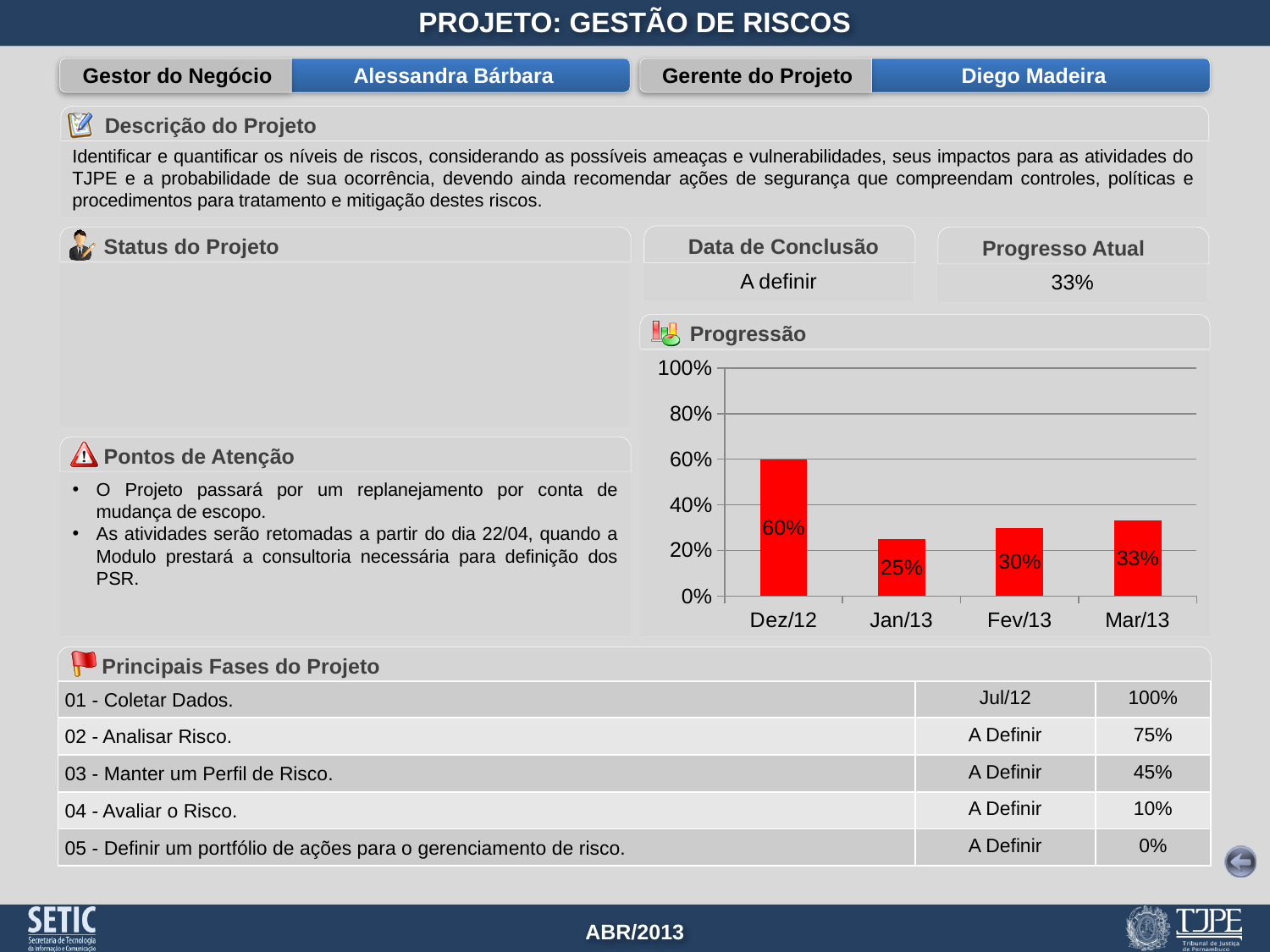
What is the value for Dez/12 in the Progressão chart? 60% In the Progressão chart, which is larger: the value for Fev/13 or the value for Jan/13? Fev/13 What is the value for Jan/13 in the Progressão chart? 25% How many months are shown on the x axis of the Progressão chart? 4 What colour are the bars in the Progressão chart? Red What kind of chart is the Progressão chart? Bar chart What is the difference between the values for Dez/12 and Jan/13 in the Progressão chart? 35% What is the value for Mar/13 in the Progressão chart? 33% Which month has the lowest value in the Progressão chart? Jan/13 What is the value for Fev/13 in the Progressão chart? 30% Which month has the highest value in the Progressão chart? Dez/12 What is the difference between the values for Mar/13 and Fev/13 in the Progressão chart? 3%